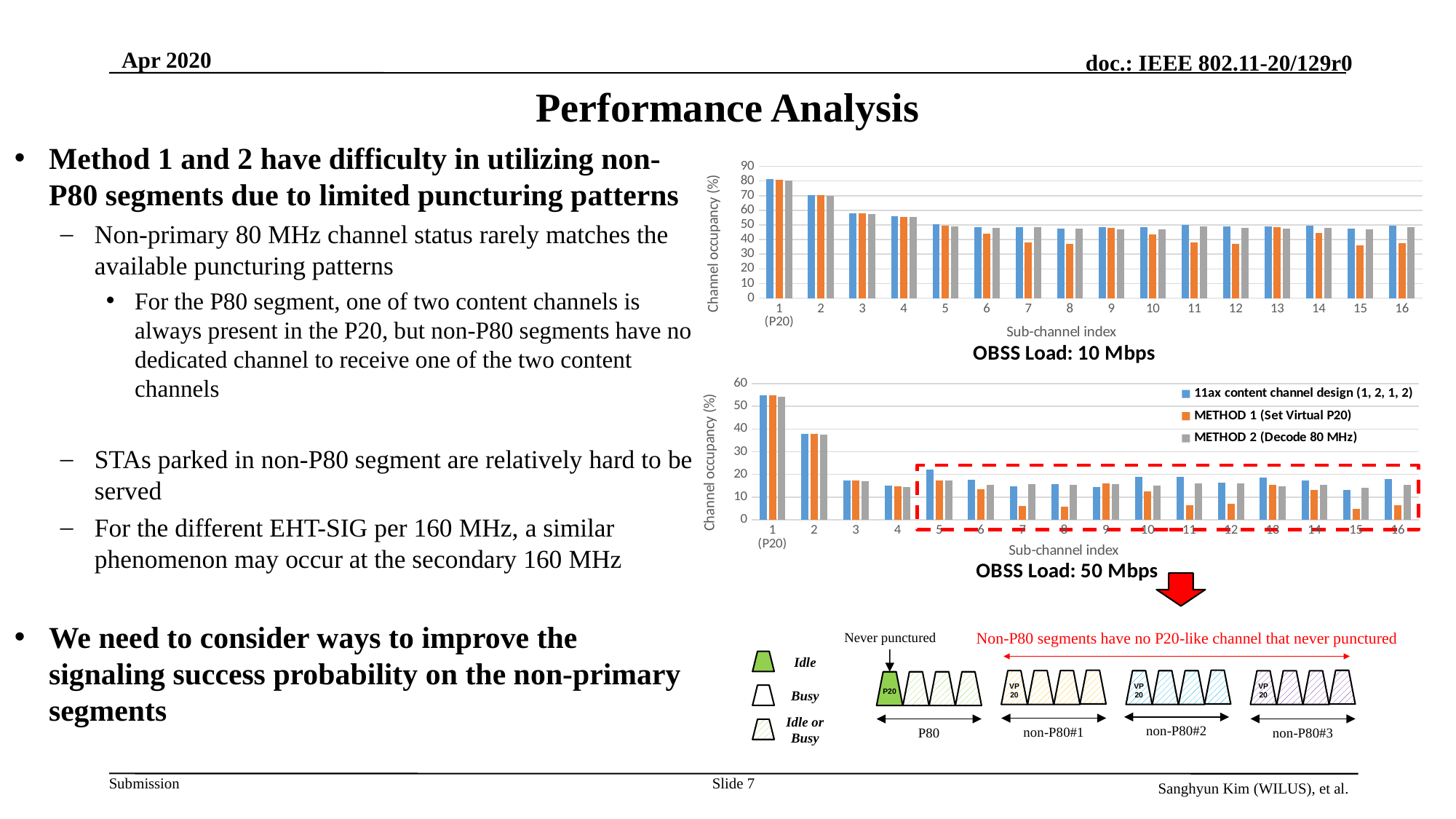
On the 'OBSS Load: 50 Mbps' chart, do the 11ax content channel design values rise or fall from sub-channel 1 (P20) to sub-channel 4? fall On the 'OBSS Load: 50 Mbps' chart, which sub-channel index has the highest channel occupancy? 1 (P20) On the 'OBSS Load: 50 Mbps' chart, is the METHOD 1 (Set Virtual P20) value for sub-channel 7 greater or less than 10? less On the 'OBSS Load: 10 Mbps' chart, is the 11ax content channel design value for sub-channel 1 (P20) greater or less than 70? greater On the 'OBSS Load: 50 Mbps' chart, is the METHOD 2 (Decode 80 MHz) value for sub-channel 1 (P20) greater or less than 50? greater What is the x-axis label on the 'OBSS Load: 10 Mbps' chart? Sub-channel index What kind of chart is the 'OBSS Load: 10 Mbps' chart? bar chart On the 'OBSS Load: 10 Mbps' chart, for sub-channel 7, which is larger: the 11ax content channel design value or the METHOD 1 (Set Virtual P20) value? 11ax content channel design How many series does the legend on the 'OBSS Load: 50 Mbps' chart list? 3 On the 'OBSS Load: 10 Mbps' chart, which sub-channel index has the highest channel occupancy? 1 (P20) How many sub-channel index categories are shown on the 'OBSS Load: 50 Mbps' chart? 16